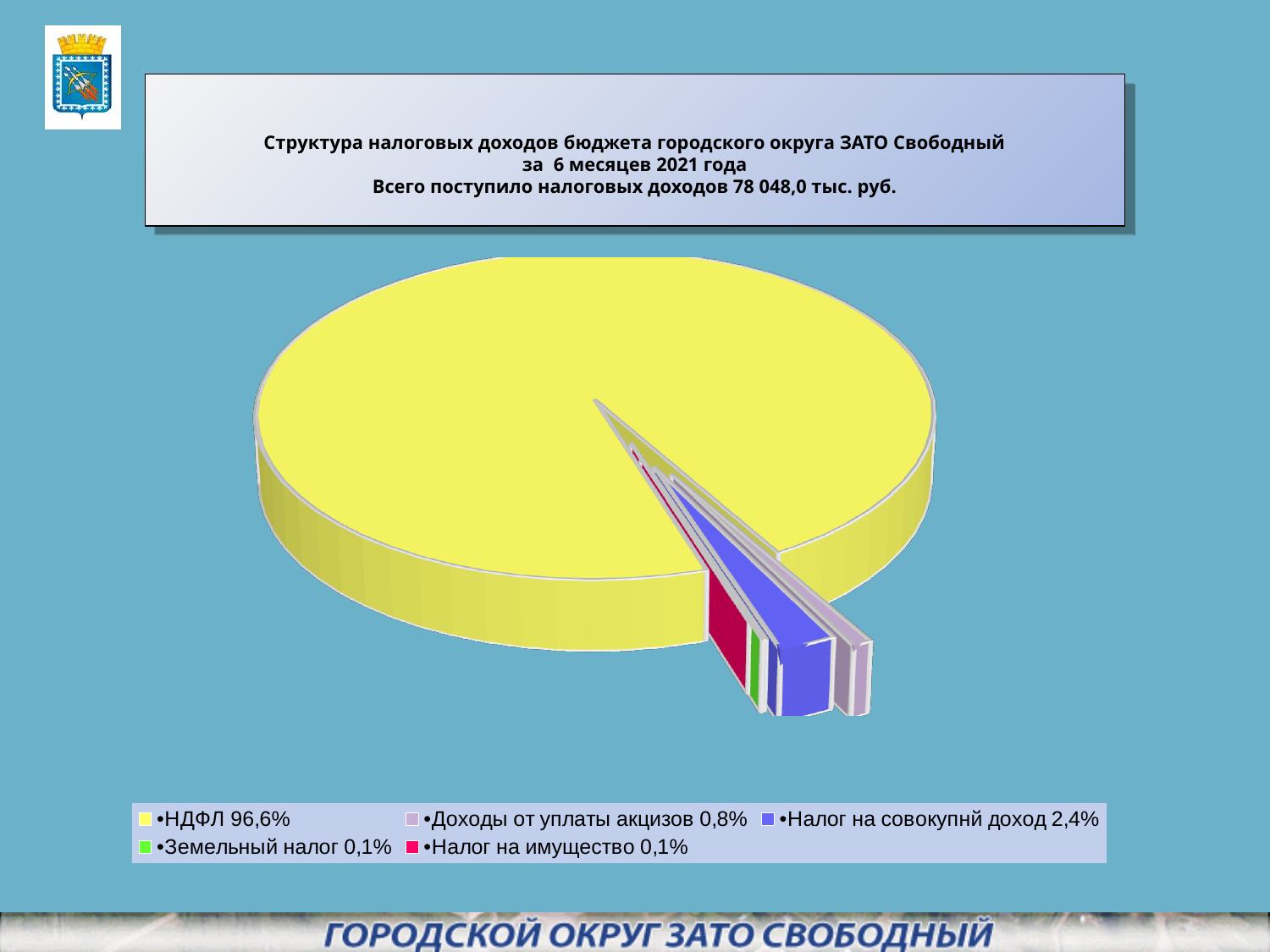
What share of tax revenues does НДФЛ account for? 96,6% Which is larger: Доходы от уплаты акцизов or Налог на совокупнй доход? Налог на совокупнй доход How many categories does the pie chart have? 5 What is the share for Земельный налог? 0,1% What is the share for Налог на совокупнй доход? 2,4% What total amount of tax revenues is stated in the chart title? 78 048,0 тыс. руб. What kind of chart is shown on the slide? pie chart Which category has the largest share of the pie? НДФЛ What colour is the НДФЛ slice in the pie chart? yellow What is the share for Доходы от уплаты акцизов? 0,8% What is the difference between the share of НДФЛ and the share of Налог на совокупнй доход? 94,2% How many categories have a share of 0,1%? 2